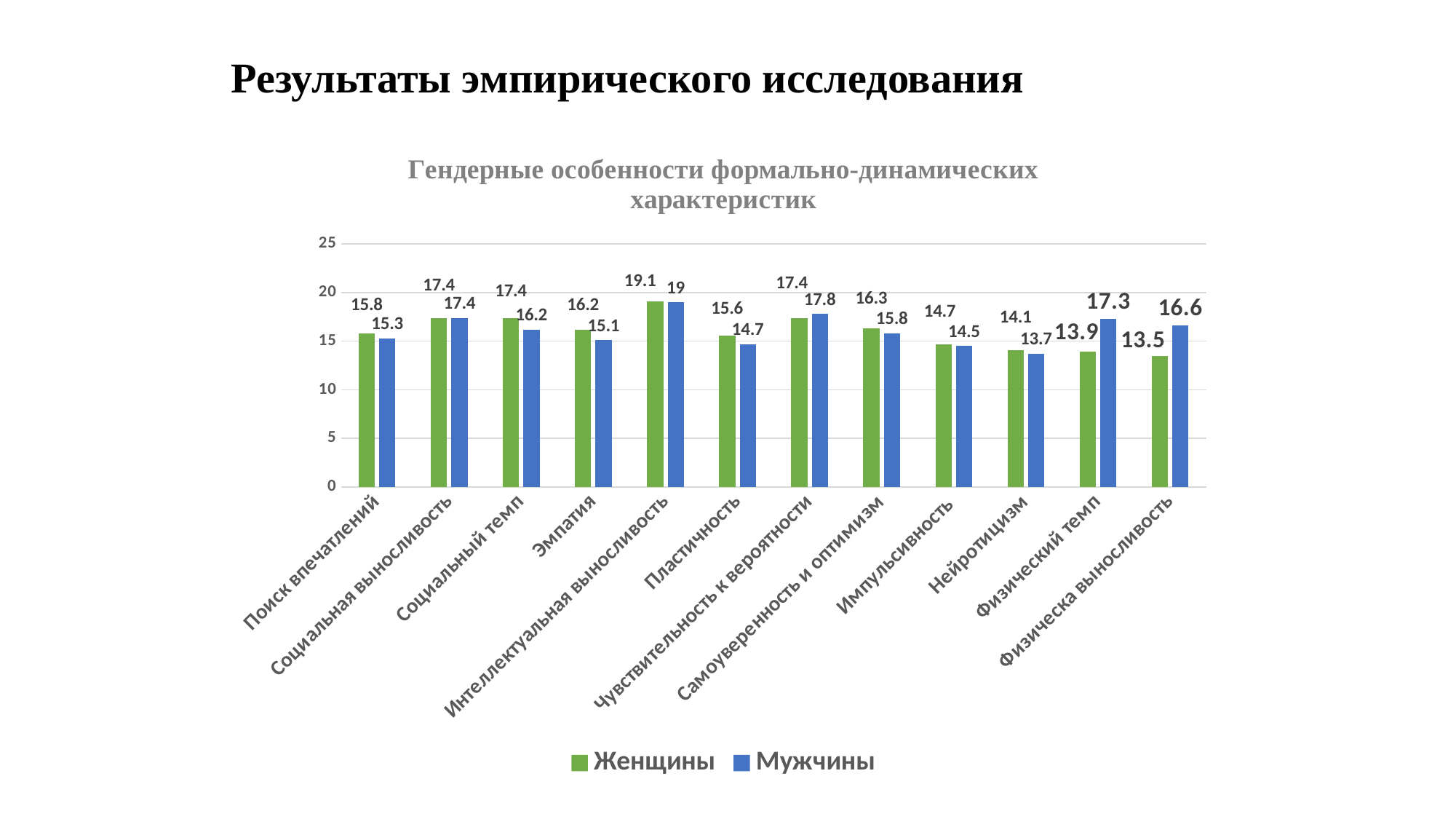
How many categories are shown on the x axis? 12 What is the value for Мужчины for Эмпатия? 15.1 Which category has the highest value for Женщины? Интеллектуальная выносливость What is the value for Женщины for Поиск впечатлений? 15.8 What is the difference between the Мужчины and Женщины values for Физический темп? 3.4 What is the value for Мужчины for Физический темп? 17.3 Which category has the lowest value for Мужчины? Нейротицизм What type of chart is shown on the slide? Bar chart For Физическа выносливость, which is larger: the value for Женщины or for Мужчины? Мужчины How many series does the legend list? 2 For Социальный темп, which is larger: the value for Женщины or for Мужчины? Женщины Which category has the lowest value for Женщины? Физическа выносливость